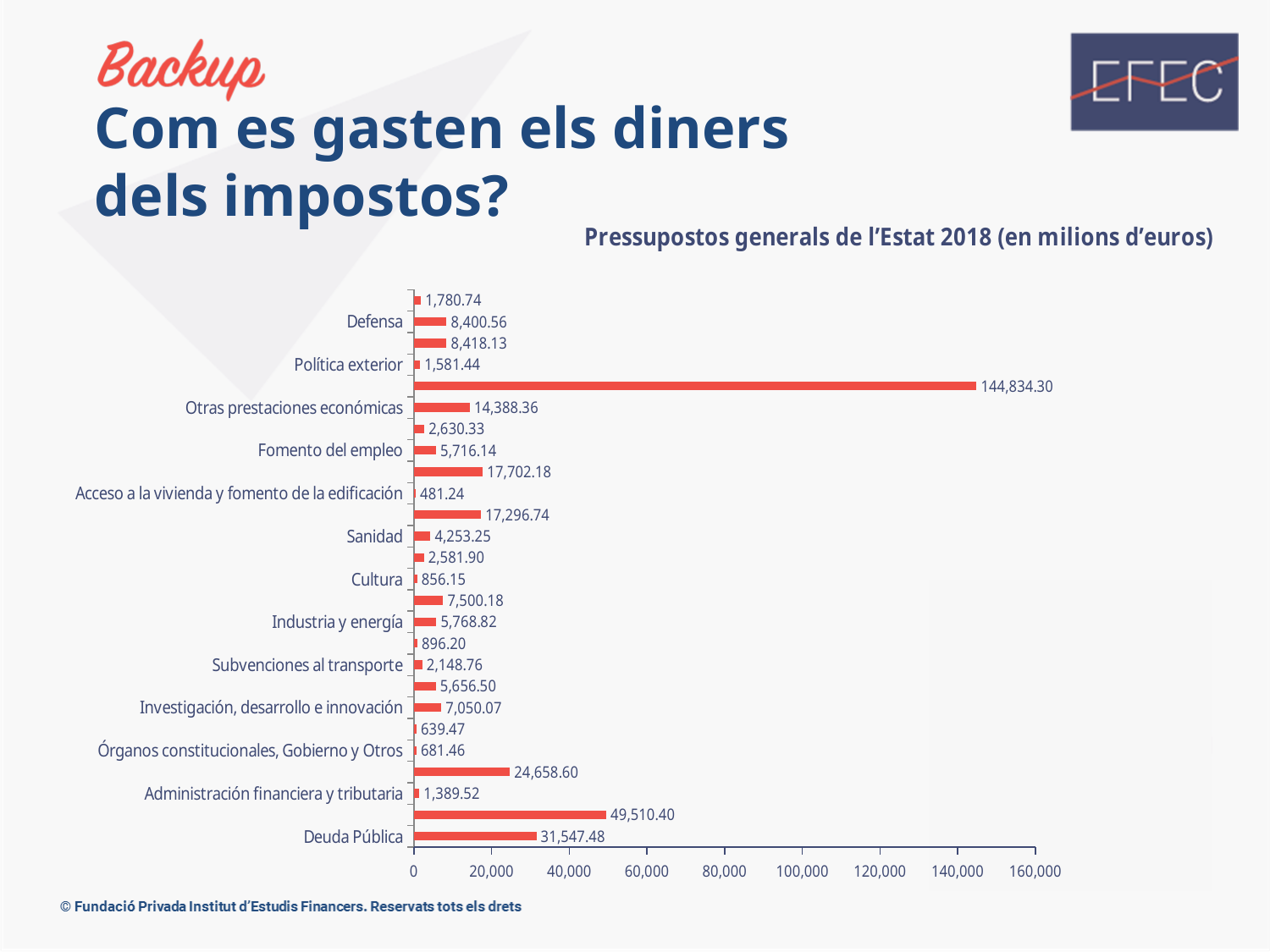
What is the difference between the values for Deuda Pública and Defensa? 23,146.92 How many bars are plotted on the chart? 26 What is the value for Defensa? 8,400.56 Which category has the smallest value on the chart? Acceso a la vivienda y fomento de la edificación What is the value for Acceso a la vivienda y fomento de la edificación? 481.24 What is the value for Deuda Pública? 31,547.48 What is the largest value shown on the chart? 144,834.30 What is the value for Otras prestaciones económicas? 14,388.36 Which is larger, the value for Sanidad or the value for Cultura? Sanidad What kind of chart is shown on the slide? bar chart What is the value for Investigación, desarrollo e innovación? 7,050.07 Is the value for Deuda Pública greater or less than 20,000? greater